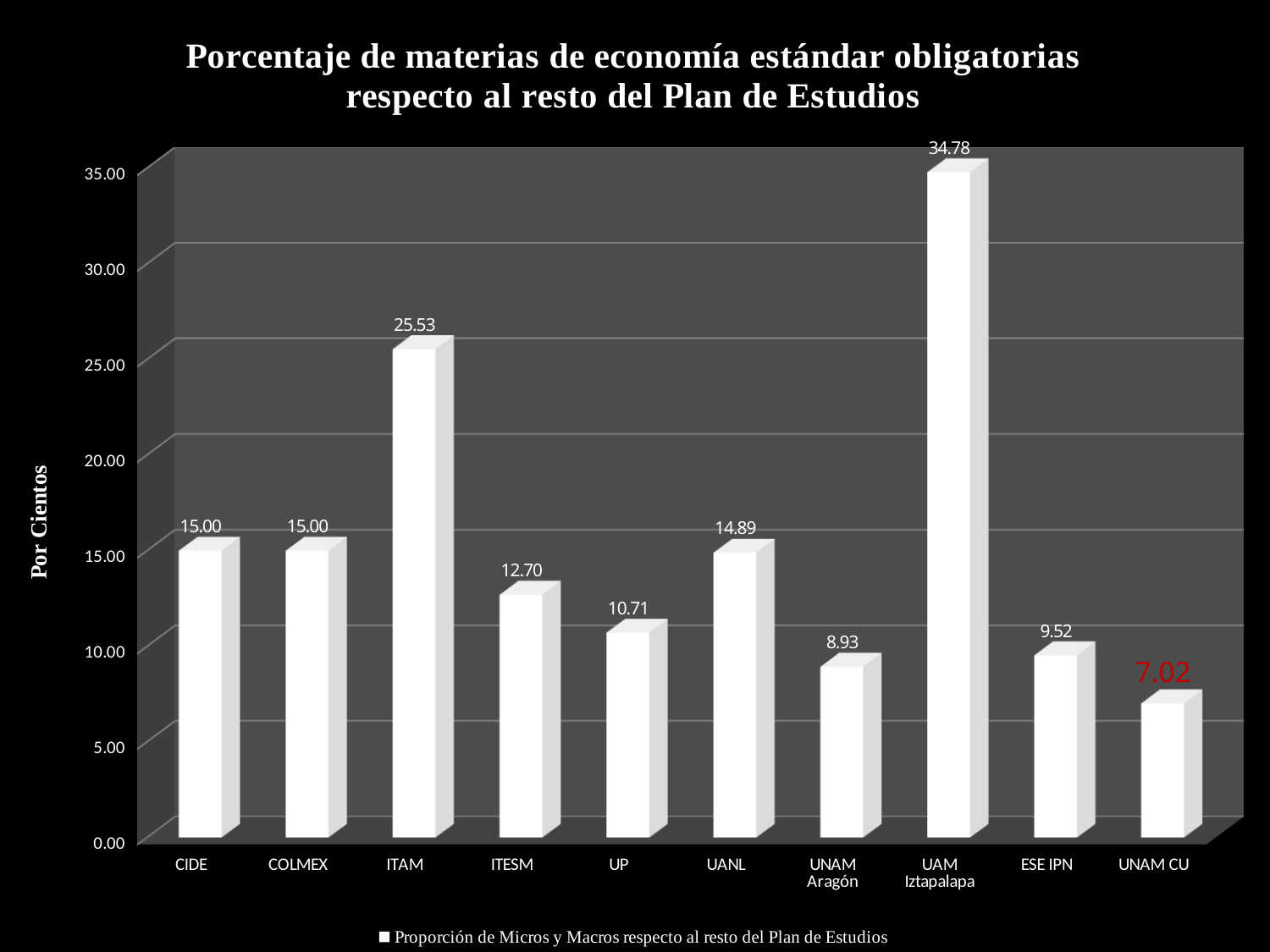
What is the label on the vertical axis? Por Cientos What is the value for ITAM? 25.53 Which category has the lowest value? UNAM CU What is the value for UNAM CU? 7.02 How many categories are shown on the x axis? 10 Which is larger, the value for ITESM or the value for UP? ITESM What is the difference between the values for UAM Iztapalapa and ITAM? 9.25 Which category has the highest value? UAM Iztapalapa What is the difference between the values for ESE IPN and UNAM CU? 2.50 What is the value for UNAM Aragón? 8.93 What kind of chart is shown on the slide? bar chart Is the value for UANL greater or less than 10.00? greater